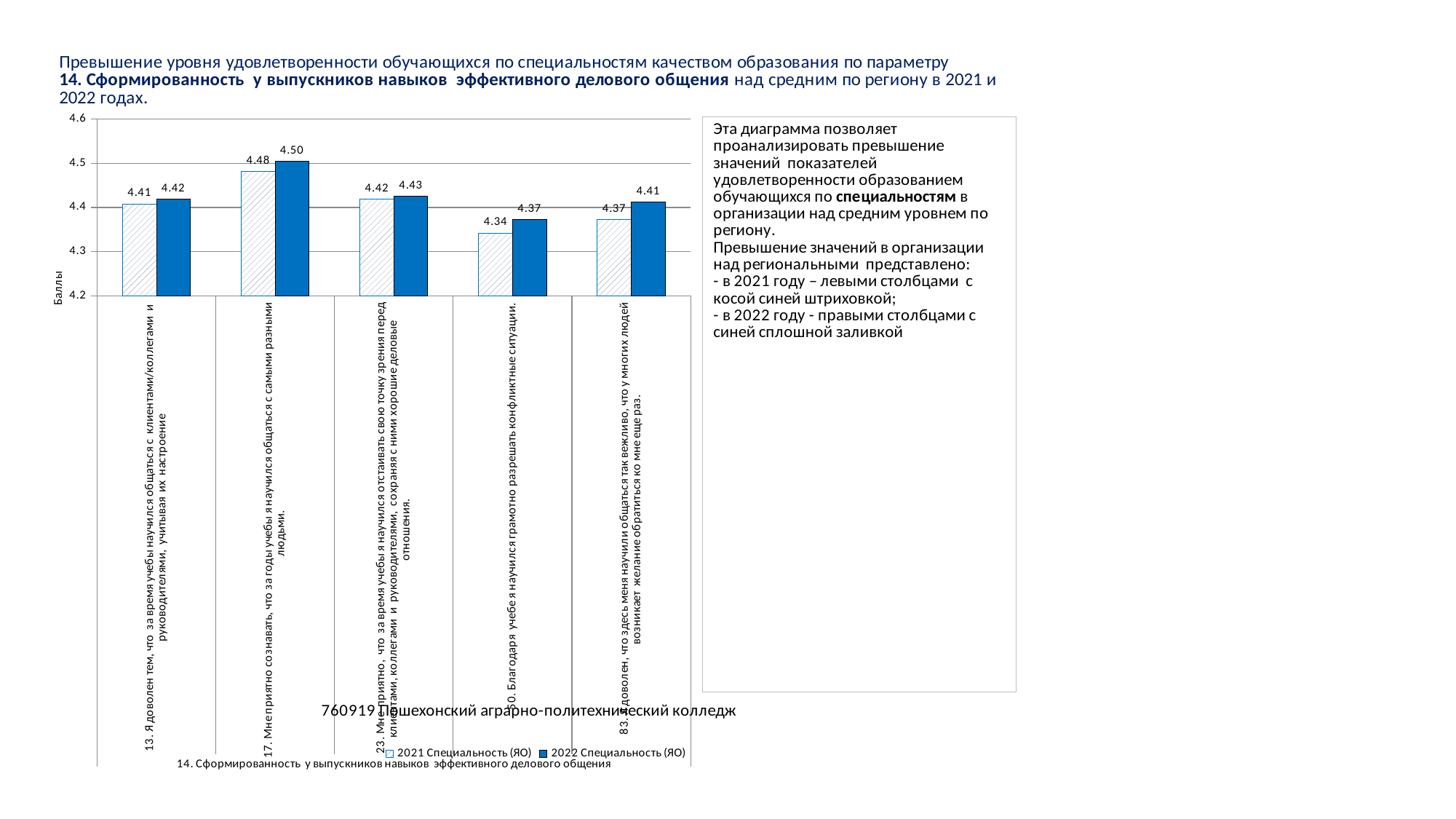
How many categories (statements) are plotted on the x axis of the chart? 5 What is the value of the 2021 Специальность (ЯО) series for statement 83 (Я доволен, что здесь меня научили общаться так вежливо...)? 4.37 How many series does the chart legend list? 2 What is the label of the vertical axis of the chart? Баллы What is the difference between the 2022 and 2021 values for statement 83? 0.04 Is the 2021 Специальность (ЯО) value for statement 17 greater or less than 4.4? greater What is the value of the 2022 Специальность (ЯО) series for statement 17 (Мне приятно сознавать, что за годы учебы я научился общаться с самыми разными людьми)? 4.50 What kind of chart is shown on the slide? bar chart Which statement has the lowest value in the 2021 Специальность (ЯО) series? 50. Благодаря учебе я научился грамотно разрешать конфликтные ситуации For statement 13, which is larger: the 2021 value or the 2022 value? 2022 value (4.42) Which statement has the highest value in the 2022 Специальность (ЯО) series? 17. Мне приятно сознавать, что за годы учебы я научился общаться с самыми разными людьми